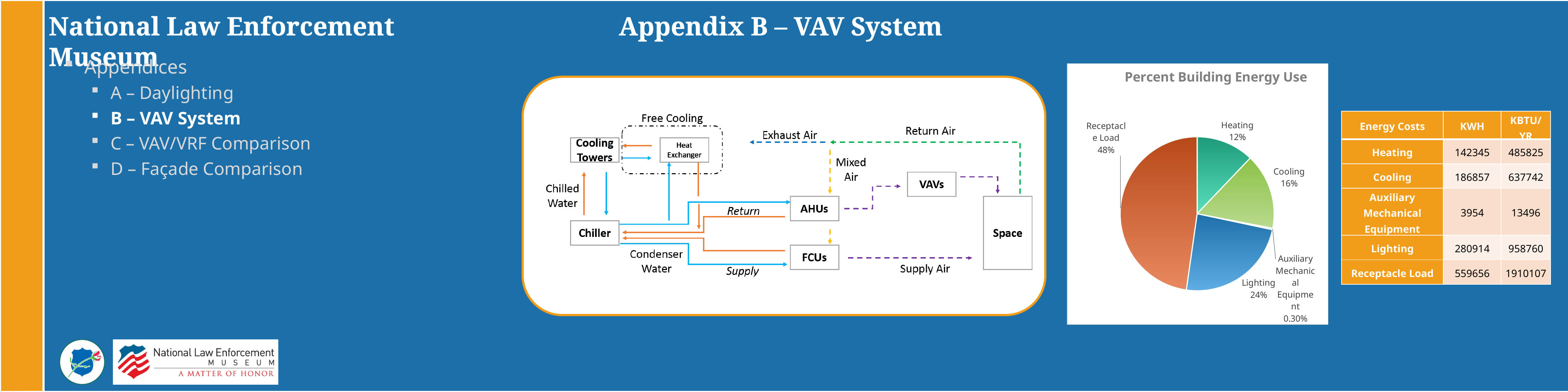
Which category has the largest slice in the pie chart? Receptacle Load What is the title of the pie chart? Percent Building Energy Use In the pie chart, what is the difference in percentage points between Receptacle Load and Lighting? 24 What kind of chart is shown on the slide? pie chart In the pie chart, which is larger: Lighting or Cooling? Lighting How many slices does the pie chart have? 5 What share of building energy use does Heating account for in the pie chart? 12% What share of building energy use does Lighting account for in the pie chart? 24% What share of building energy use does Auxiliary Mechanical Equipment account for in the pie chart? 0.30% Which category has the smallest slice in the pie chart? Auxiliary Mechanical Equipment